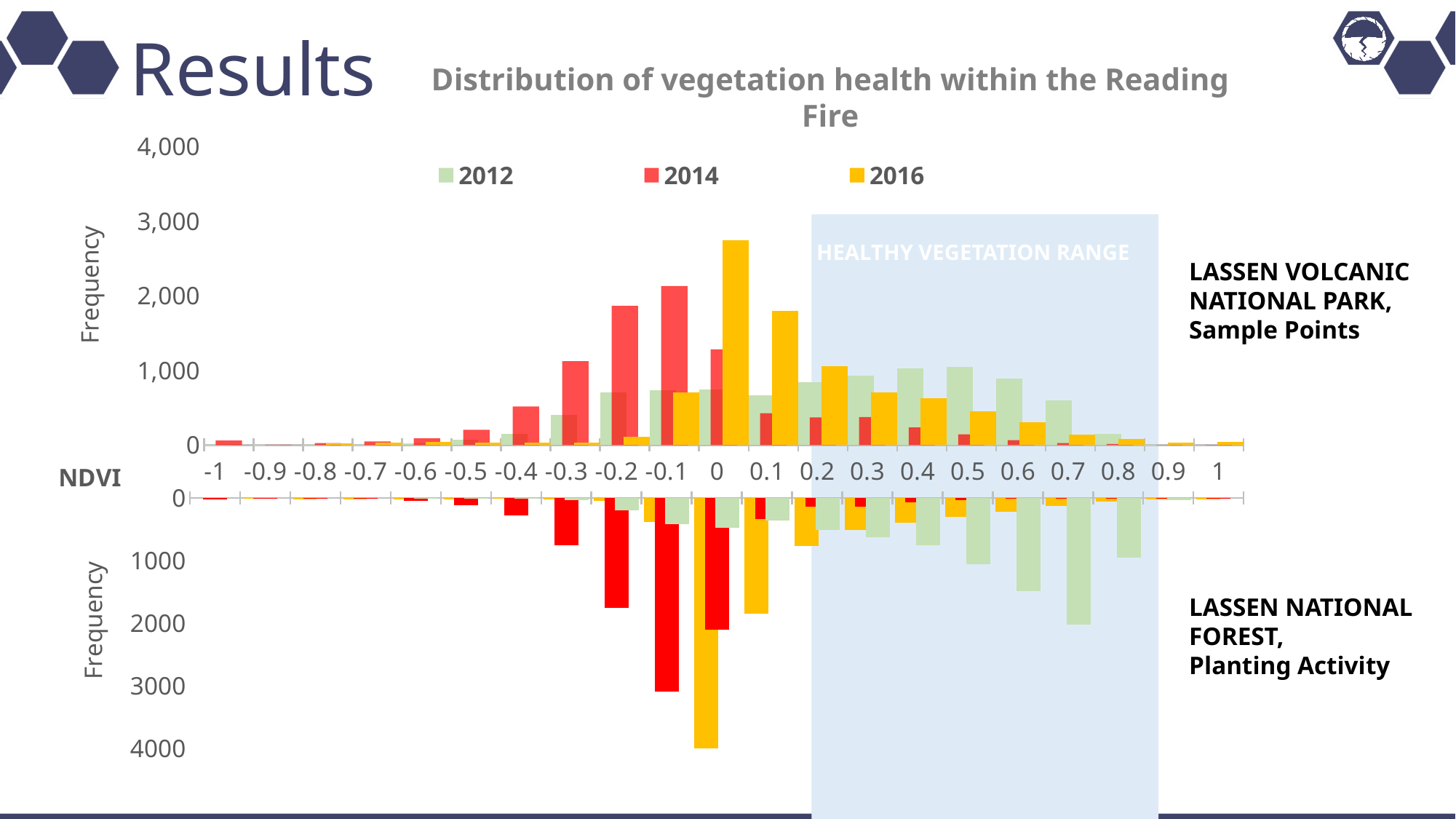
In the top chart (Lassen Volcanic National Park, Sample Points), which series has the tallest bar overall? 2016 How many series does the legend list? 3 What kind of chart is used for the Lassen Volcanic National Park, Sample Points data? Bar chart In the bottom chart (Lassen National Forest, Planting Activity), which is larger: the 2016 bar at NDVI 0 or the 2014 bar at NDVI -0.1? 2016 bar at NDVI 0 What is the title of the chart on the slide? Distribution of vegetation health within the Reading Fire How many NDVI categories are shown along the x axis? 21 In the bottom chart (Lassen National Forest, Planting Activity), which series has the largest bar overall? 2016 What label is shown on the shaded region covering NDVI 0.2 to 0.9? HEALTHY VEGETATION RANGE In the top chart (Lassen Volcanic National Park, Sample Points), is the 2016 value at NDVI 0 greater or less than 2,000? greater In the top chart (Lassen Volcanic National Park, Sample Points), which series has the tallest bar at NDVI 0.5? 2012 In the bottom chart (Lassen National Forest, Planting Activity), is the 2014 value at NDVI -0.1 greater or less than 2000? greater In the top chart (Lassen Volcanic National Park, Sample Points), is the 2014 value at NDVI -0.1 greater or less than 1,000? greater